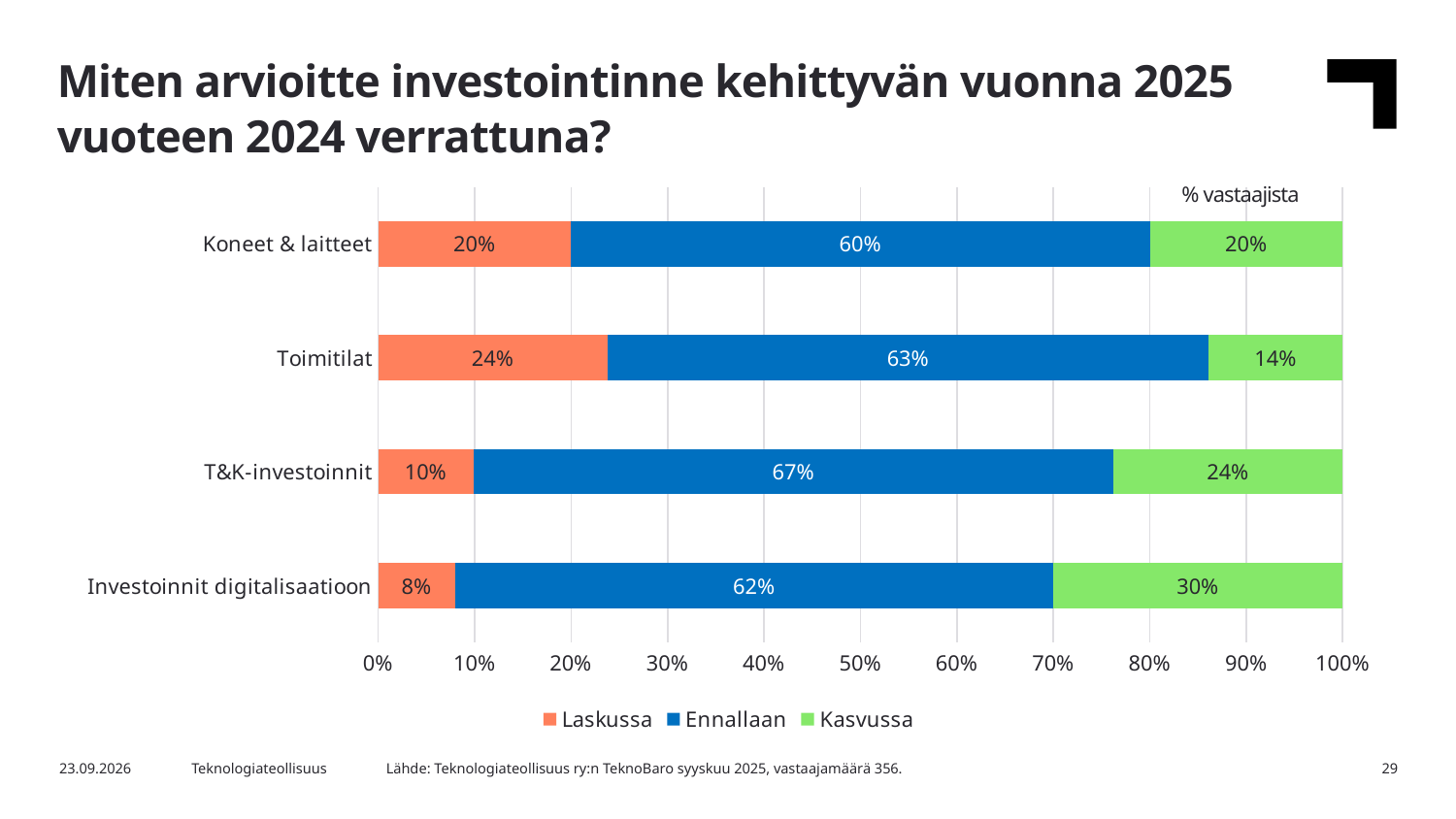
Which series is shown in blue in the legend? Ennallaan What is the difference between the Kasvussa values for T&K-investoinnit and Toimitilat? 10% Which category has the lowest Laskussa value? Investoinnit digitalisaatioon What is the Ennallaan value for T&K-investoinnit? 67% What is the Laskussa value for Toimitilat? 24% What is the Ennallaan value for Koneet & laitteet? 60% Which category has the highest Kasvussa value? Investoinnit digitalisaatioon How many categories are shown on the chart? 4 How many series does the legend list? 3 What kind of chart is shown on the slide? Stacked bar chart Which is larger: the Laskussa value for Koneet & laitteet or the Laskussa value for T&K-investoinnit? Koneet & laitteet What is the Kasvussa value for Investoinnit digitalisaatioon? 30%